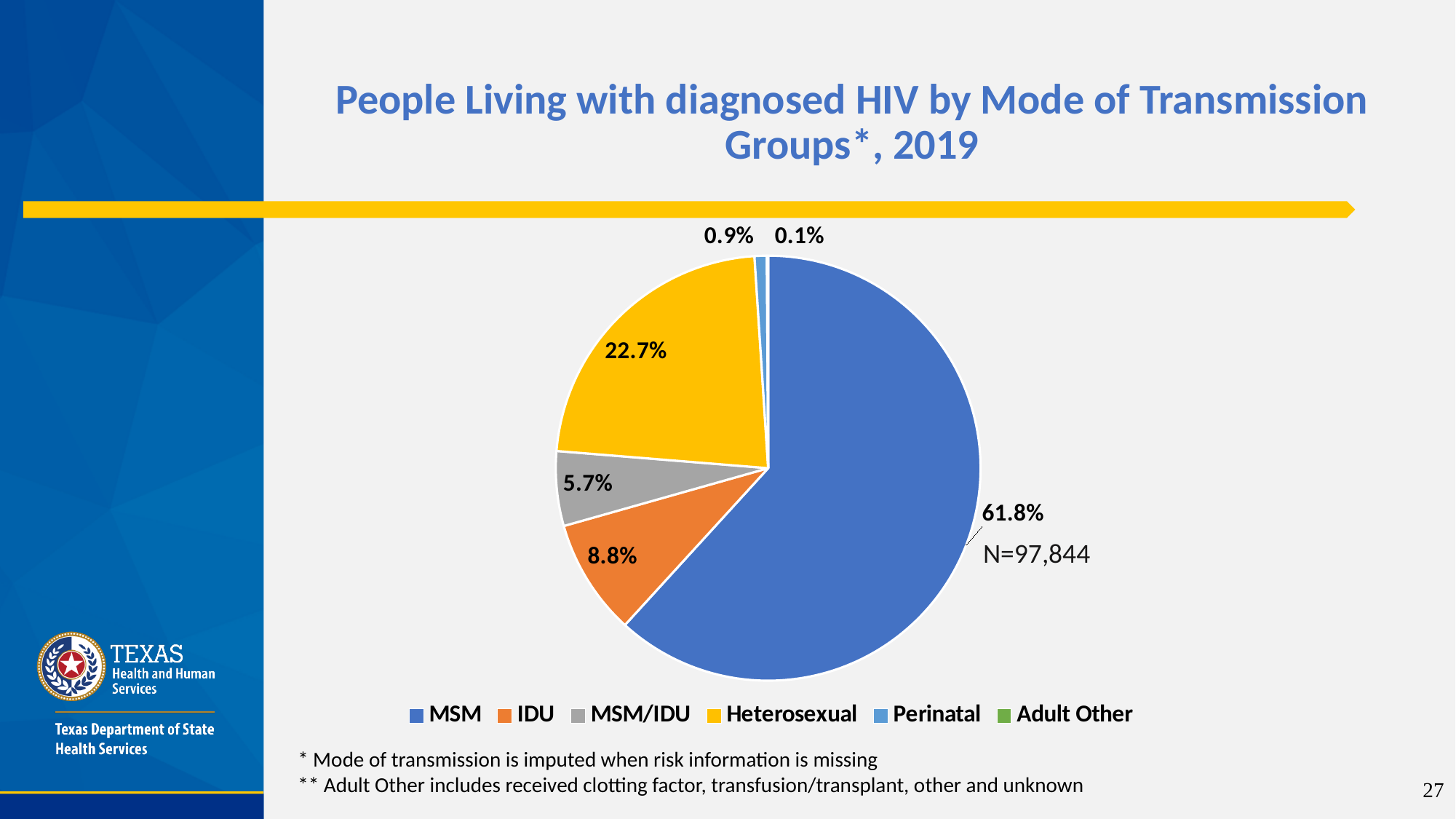
What is the value for Perinatal? 0.9% Which mode of transmission group has the smallest share of the pie? Adult Other What is the total N shown on the chart? N=97,844 Which mode of transmission group has the largest share of the pie? MSM What is the difference in percentage points between the MSM and Heterosexual slices? 39.1 What is the value shown for IDU? 8.8% What percentage is shown for MSM/IDU? 5.7% What share of people living with diagnosed HIV is attributed to MSM? 61.8% What type of chart is shown on the slide? pie chart Which is larger, the IDU slice or the MSM/IDU slice? IDU What percentage does the Heterosexual slice represent? 22.7% How many mode of transmission groups does the legend list? 6